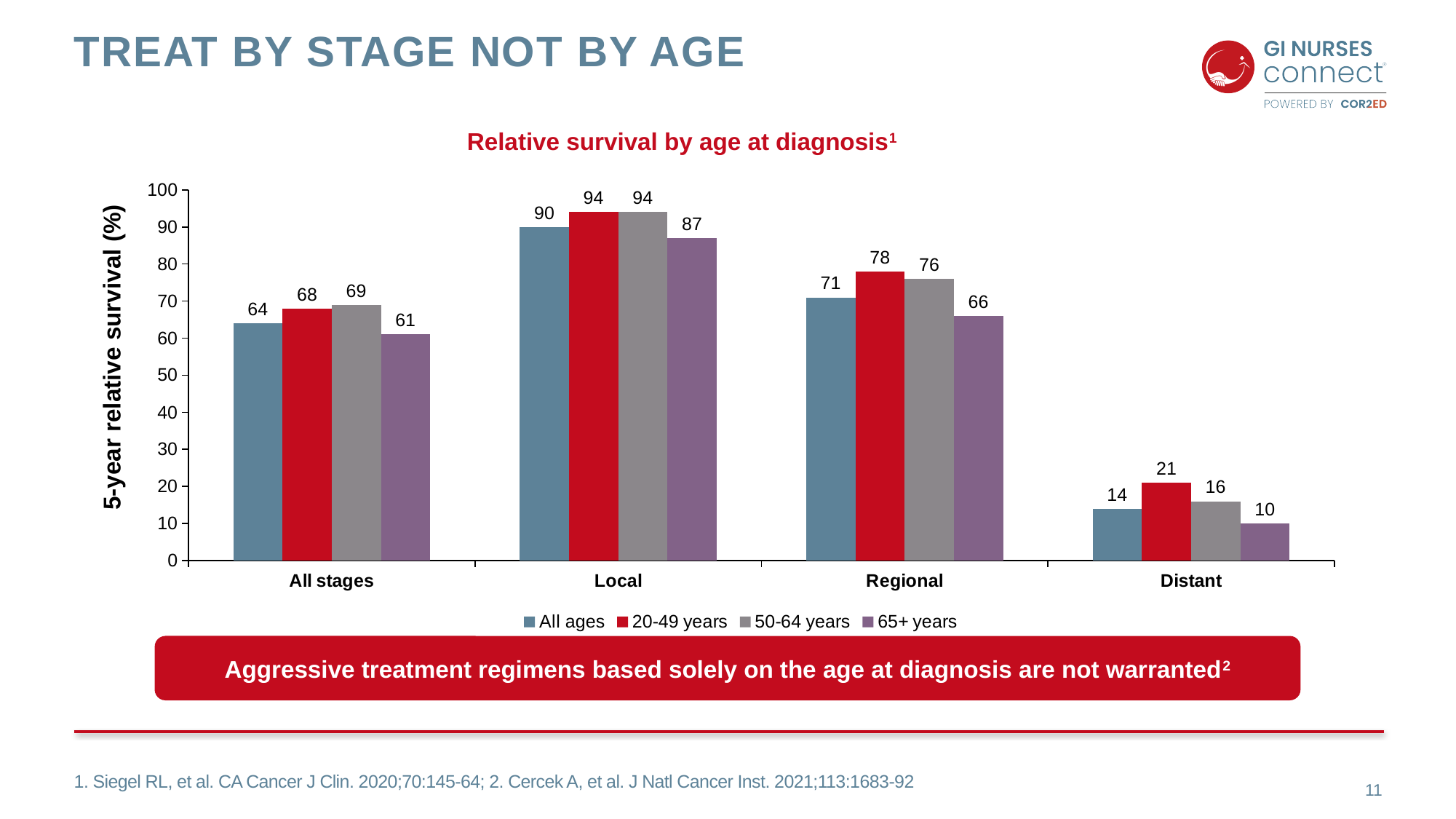
What is the 5-year relative survival for the 65+ years group at the Distant stage? 10 In the All stages category, which is larger: the value for 50-64 years or the value for 65+ years? 50-64 years Which stage category has the lowest 5-year relative survival for the 65+ years group? Distant What is the value for All ages in the Regional category? 71 Is the value for All ages at the Local stage greater or less than 80? greater What is the label of the y axis? 5-year relative survival (%) What is the difference between the 20-49 years and 65+ years values in the Distant category? 11 Which age group has the highest 5-year relative survival in the Regional category? 20-49 years What is the 5-year relative survival for the 20-49 years group at the Local stage? 94 What kind of chart is shown on the slide? Bar chart How many stage categories are shown on the x axis? 4 How many series does the legend list? 4